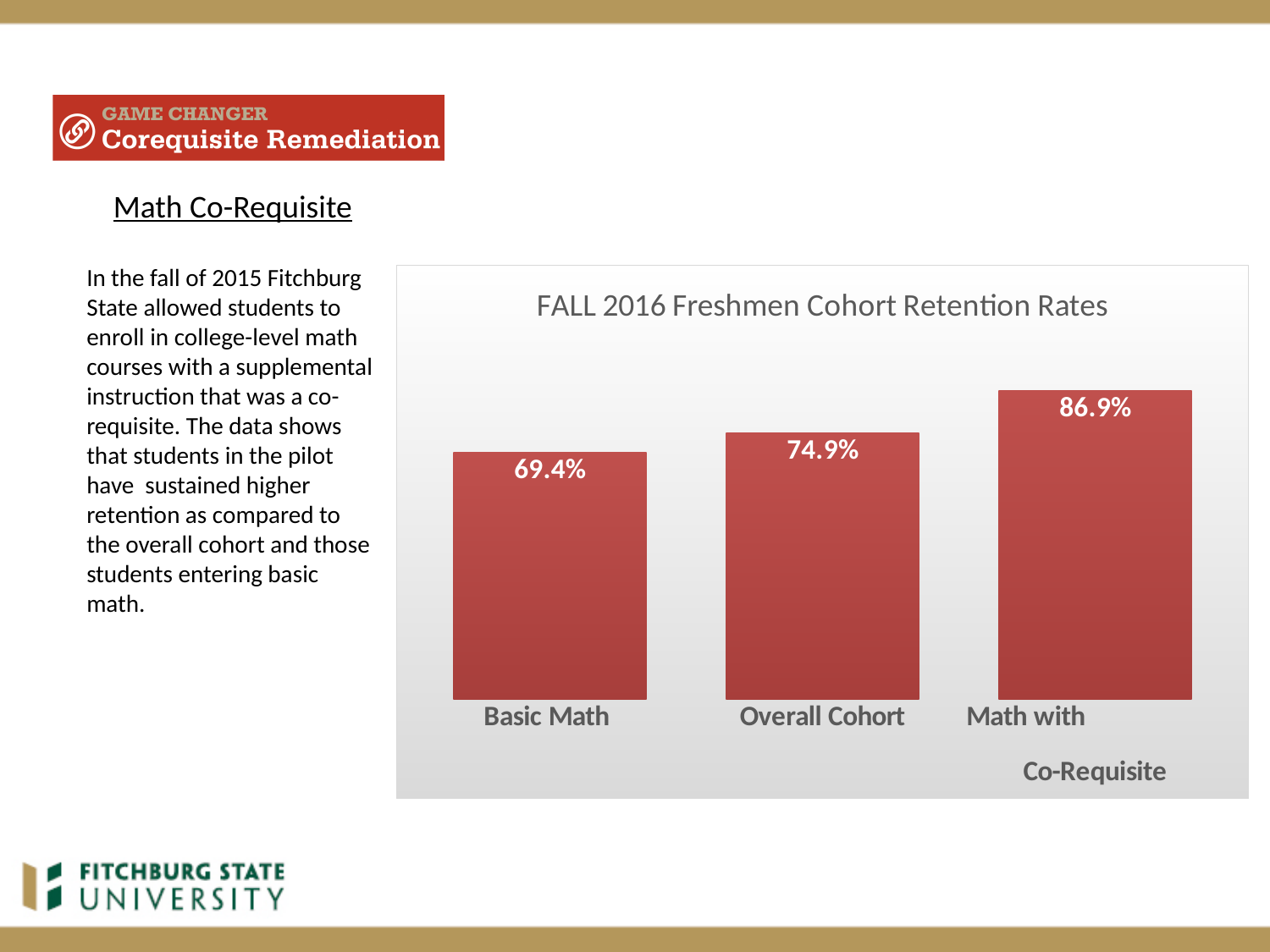
Do the retention rates rise or fall from left to right across the categories? Rise What is the retention rate for the Overall Cohort? 74.9% Which category has the highest retention rate? Math with Co-Requisite Which is larger, the retention rate for Overall Cohort or for Math with Co-Requisite? Math with Co-Requisite What is the retention rate for Basic Math? 69.4% Which category has the lowest retention rate? Basic Math What is the title of the chart? FALL 2016 Freshmen Cohort Retention Rates What is the retention rate for Math with Co-Requisite? 86.9% How many categories are shown in the chart? 3 What is the difference between the retention rates for Overall Cohort and Basic Math? 5.5% What kind of chart is shown on the slide? Bar chart What is the difference between the retention rates for Math with Co-Requisite and Basic Math? 17.5%